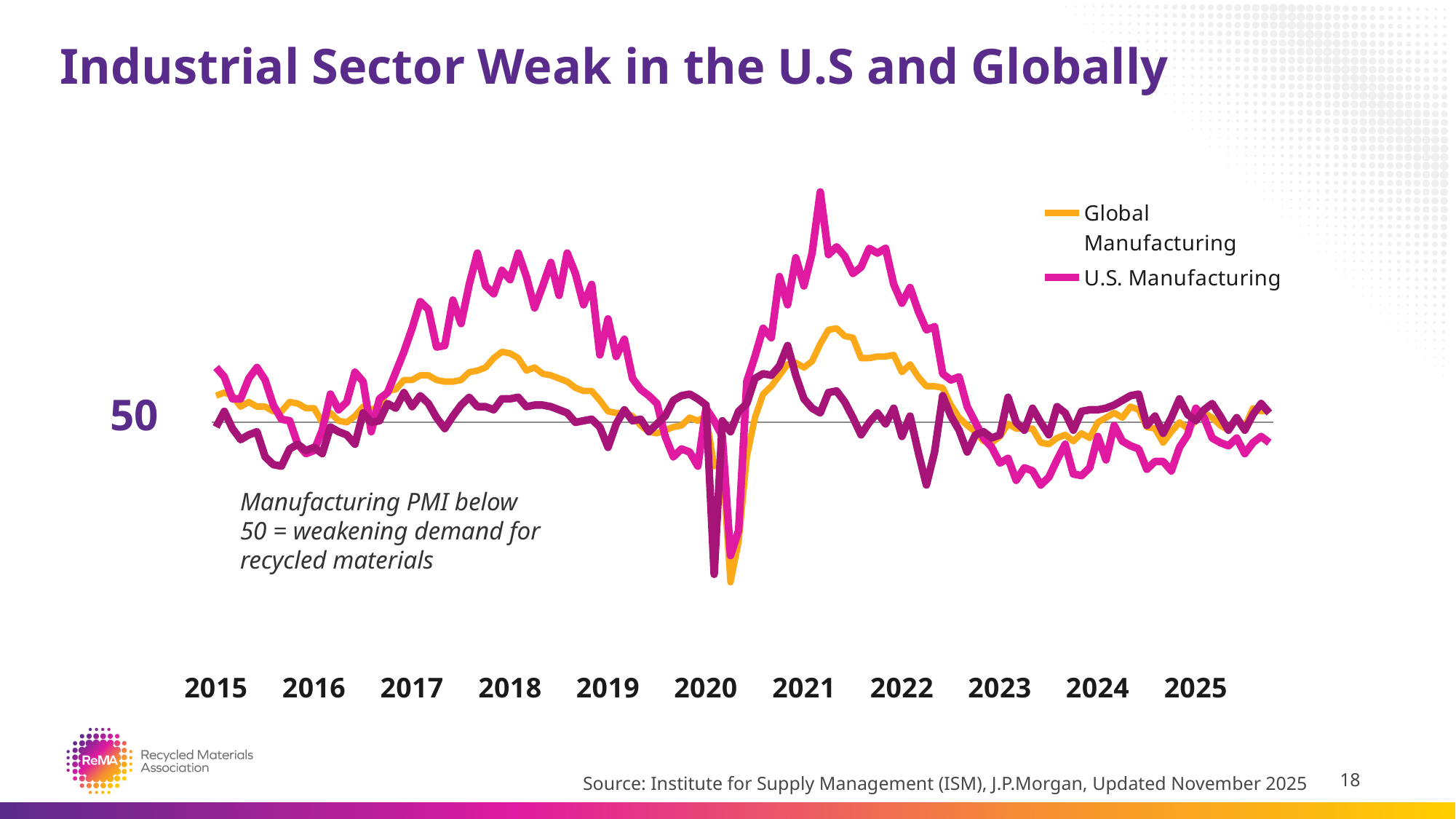
How many series does the legend list? 2 Is the value for Global Manufacturing in 2018 greater or less than 50? greater How many year labels are shown along the x axis? 11 Does the U.S. Manufacturing line rise or fall from its 2021 peak to 2023? fall What kind of chart is shown on the slide? line chart In which year does the Global Manufacturing line reach its lowest point? 2020 Is the lowest value for Global Manufacturing in 2020 greater or less than 50? less What is the only value labelled on the vertical axis? 50 Is the value for U.S. Manufacturing in 2023 greater or less than 50? less In which year does the U.S. Manufacturing line reach its highest point? 2021 Which legend entry is drawn in orange? Global Manufacturing